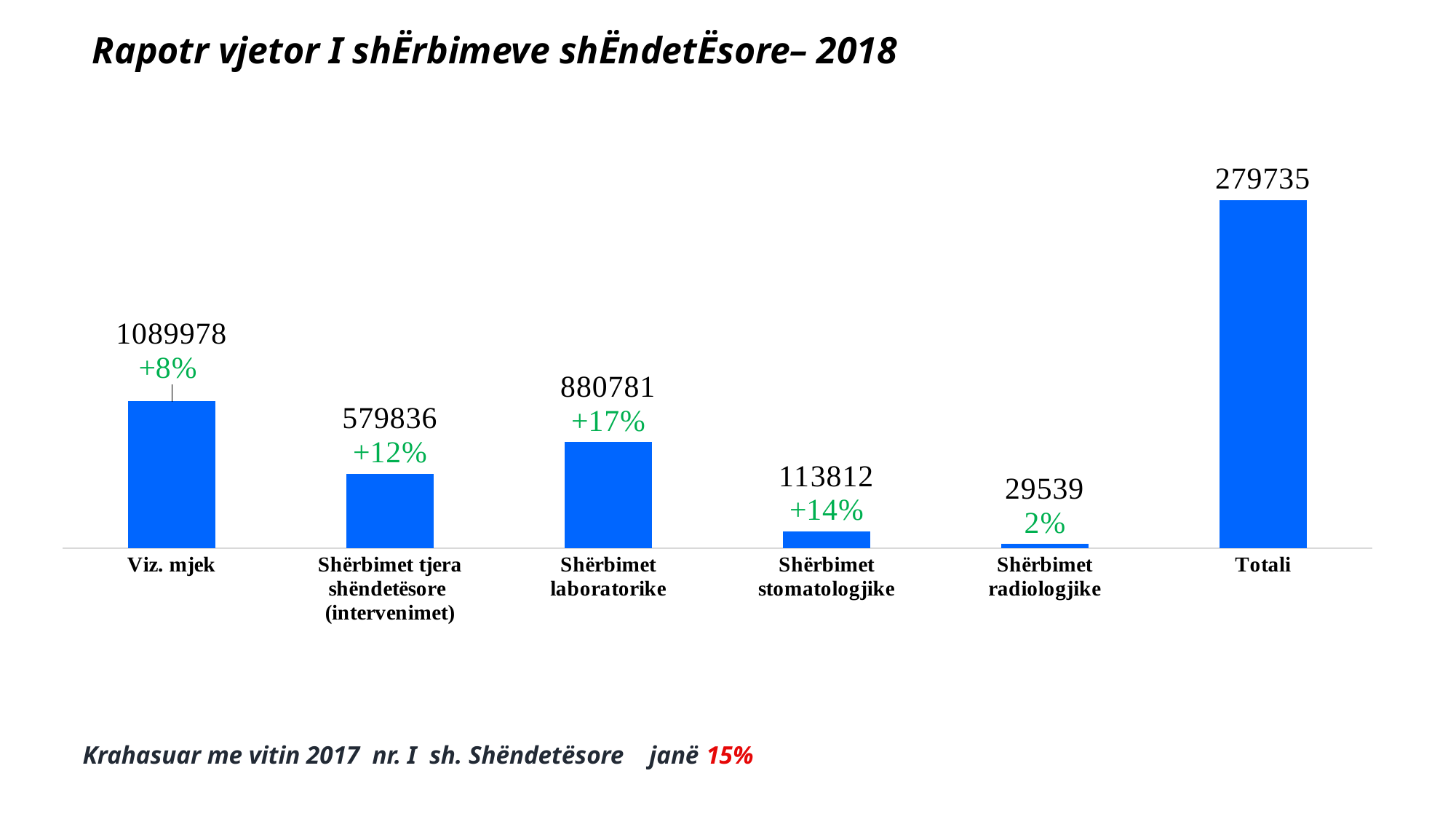
What is the value shown for Viz. mjek? 1089978 What is the value shown for Shërbimet stomatologjike? 113812 How many categories are shown on the x axis? 6 What is the value shown for Shërbimet laboratorike? 880781 What is the value shown for Shërbimet radiologjike? 29539 Which is larger, the value for Shërbimet laboratorike or the value for Shërbimet tjera shëndetësore (intervenimet)? Shërbimet laboratorike What kind of chart is shown on the slide? bar chart What is the difference between the values for Shërbimet stomatologjike and Shërbimet radiologjike? 84273 What percentage change is shown above the Shërbimet tjera shëndetësore (intervenimet) bar? +12% Which category has the lowest value? Shërbimet radiologjike What is the difference between the values for Viz. mjek and Shërbimet laboratorike? 209197 What percentage change is shown above the Shërbimet laboratorike bar? +17%